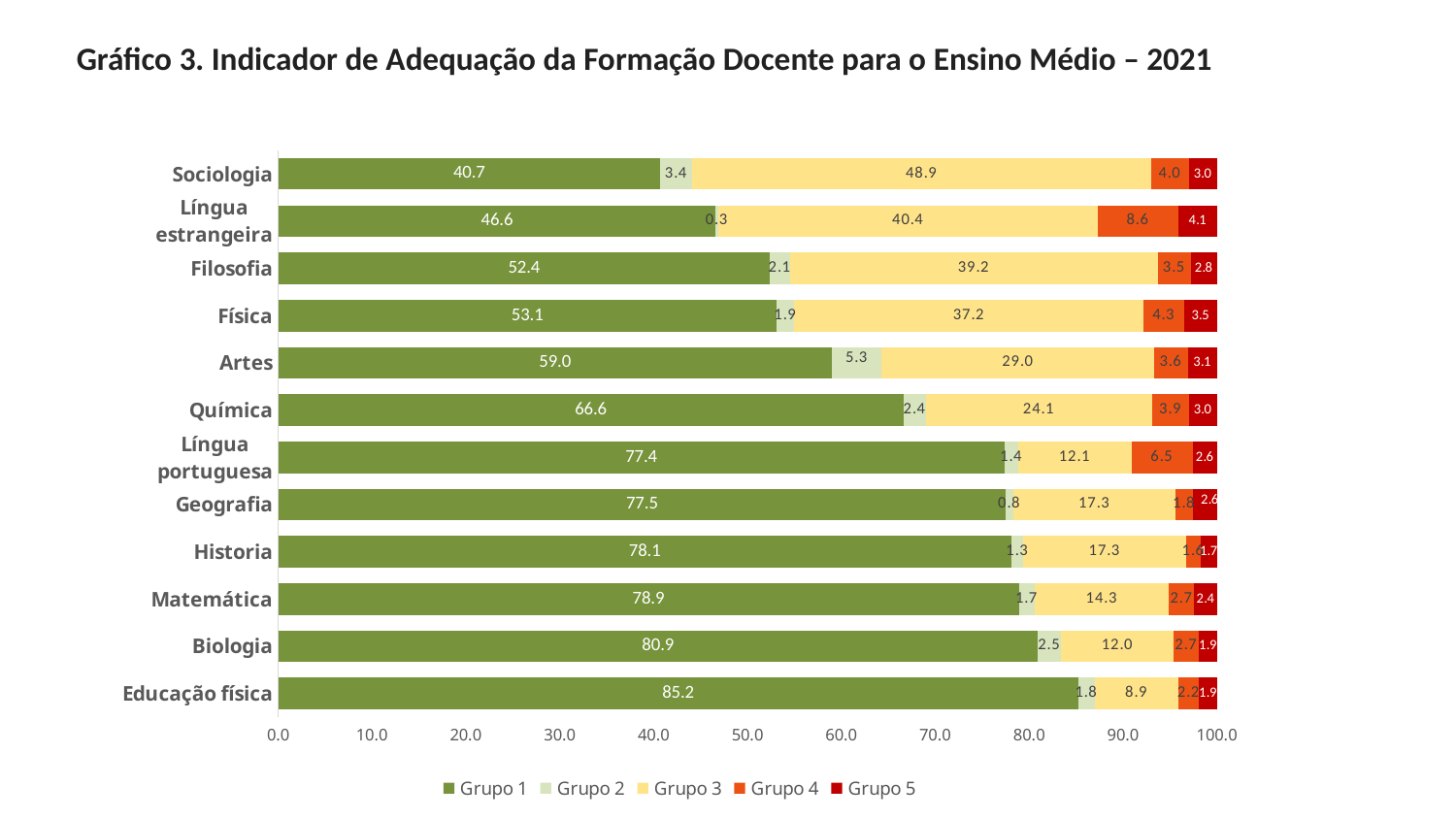
What is the Grupo 4 value for Língua portuguesa? 6.5 Is the Grupo 1 value for Química greater or less than 60.0? greater Which category has the highest Grupo 1 value? Educação física Which category has the lowest Grupo 1 value? Sociologia How many series does the legend list? 5 What is the Grupo 1 value for Sociologia? 40.7 How many categories (subjects) are shown on the chart? 12 What is the total of the stacked bar for Sociologia? 100.0 Which is larger, the Grupo 3 value for Artes or the Grupo 3 value for Química? Artes What kind of chart is shown on the slide? Stacked bar chart What is the difference between the Grupo 1 values for Educação física and Sociologia? 44.5 What is the Grupo 3 value for Língua estrangeira? 40.4